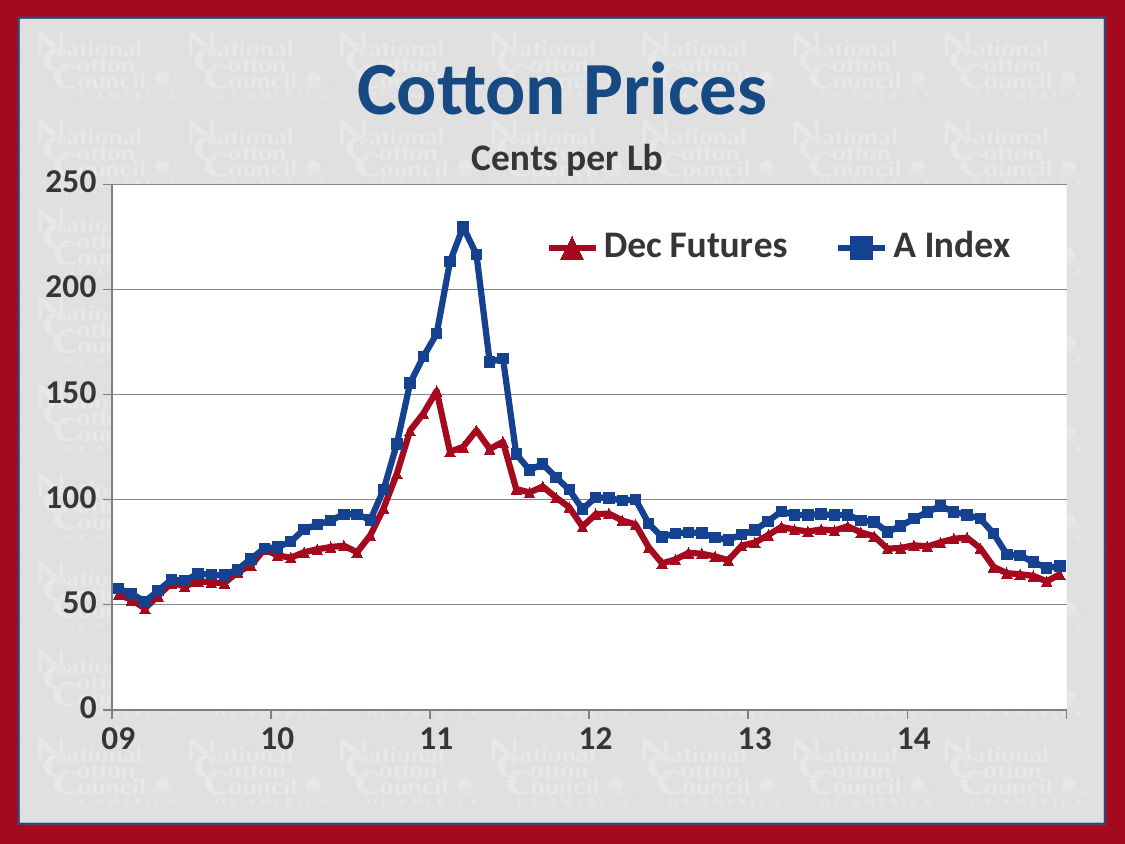
At 11, which series has the higher value, Dec Futures or A Index? A Index Do the A Index values rise or fall between 11 and 12? fall What is the title of the chart? Cotton Prices Is the peak value of the A Index greater or less than 200? greater Is the peak value of Dec Futures greater or less than 200? less What kind of chart is shown on the slide? line chart How many year labels are shown on the x axis? 6 What unit is shown below the chart title? Cents per Lb Is the Dec Futures value at 14 greater or less than 100? less How many series does the legend list? 2 Which series reaches the highest value on the chart? A Index